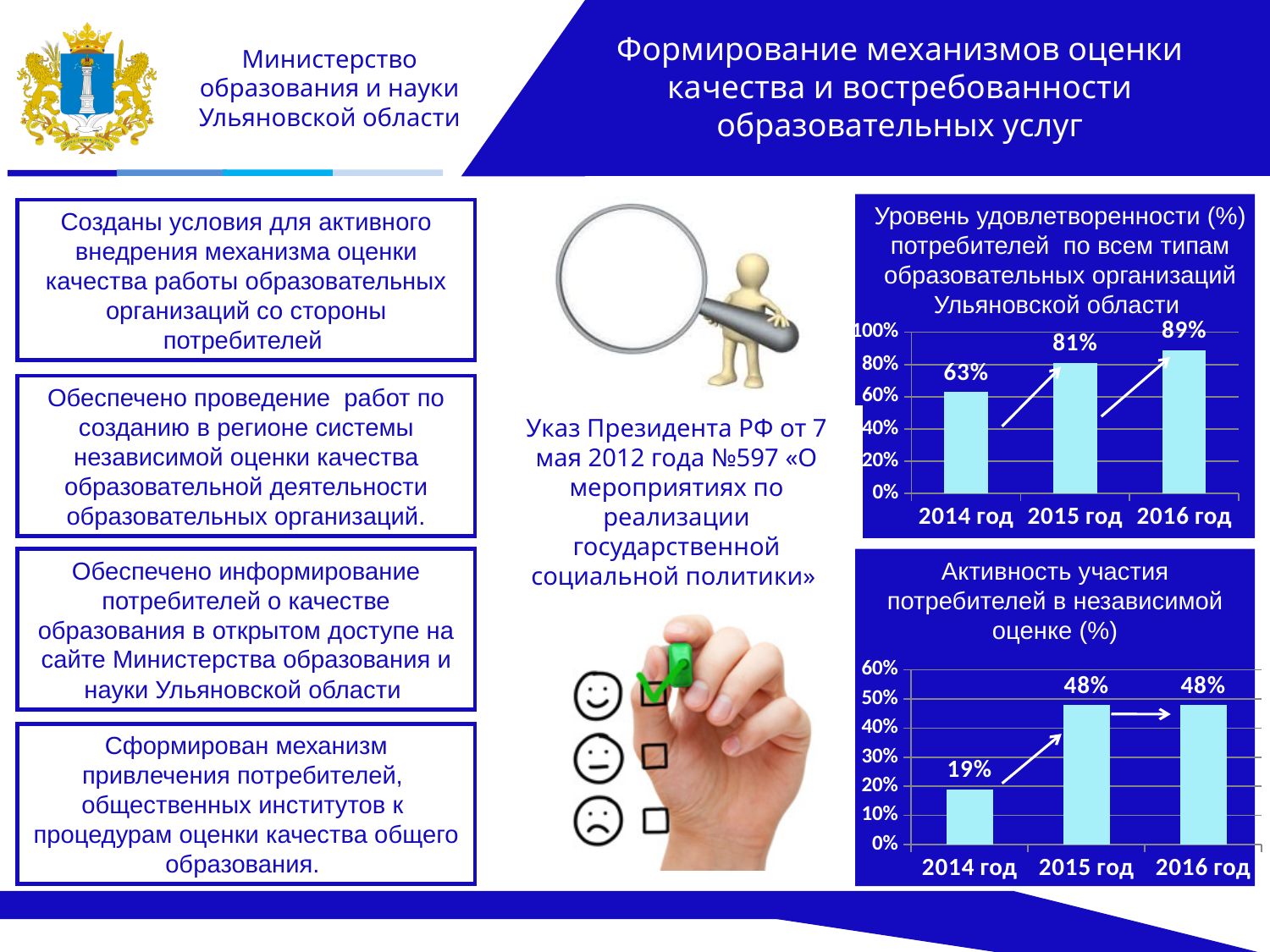
In the top-right chart (Уровень удовлетворенности), what is the difference between the 2016 год and 2014 год values? 26% In the top-right chart (Уровень удовлетворенности), what is the value for 2014 год? 63% In the top-right chart (Уровень удовлетворенности), what is the value for 2016 год? 89% In the bottom-right chart (Активность участия), what is the value for 2014 год? 19% In the bottom-right chart (Активность участия), what is the value for 2015 год? 48% In the bottom-right chart (Активность участия), is the value for 2015 год greater or less than 40%? greater In the top-right chart (Уровень удовлетворенности), how many years are plotted? 3 What type of chart is the bottom-right chart (Активность участия)? bar chart In the top-right chart (Уровень удовлетворенности), do the values rise or fall from 2014 год to 2016 год? rise In the top-right chart (Уровень удовлетворенности), which year has the lowest value? 2014 год In the bottom-right chart (Активность участия), what is the difference between the 2015 год and 2014 год values? 29% In the bottom-right chart (Активность участия), which year has the lowest value? 2014 год